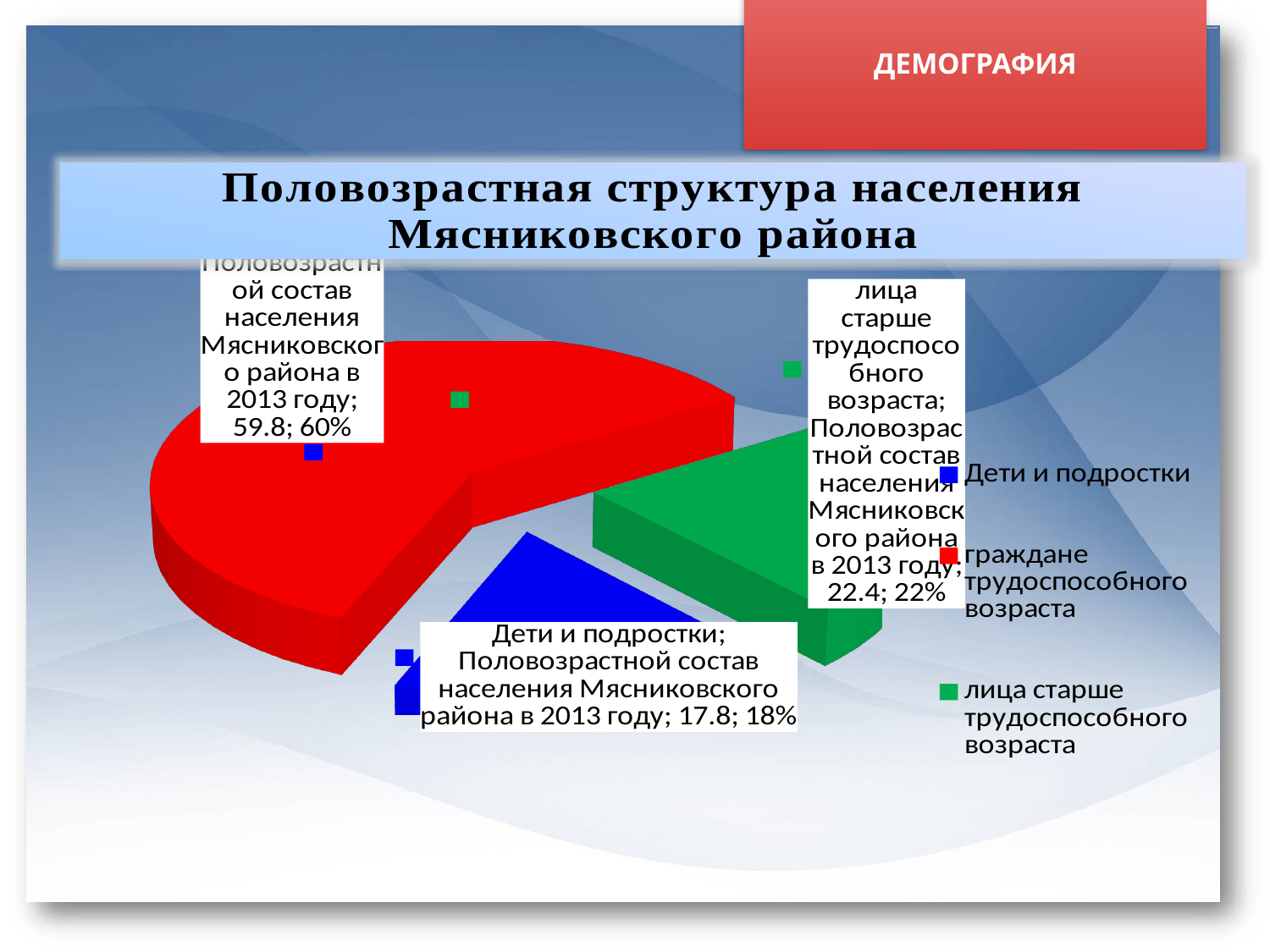
What value is printed on the data label of the red slice (граждане трудоспособного возраста)? 59.8 How many slices does the pie chart have? 3 Which category has the smallest slice in the pie chart? Дети и подростки What kind of chart is shown on the slide? pie chart Which category has the largest slice in the pie chart? граждане трудоспособного возраста What percentage share does the slice for "Дети и подростки" have in the pie chart? 18% Which colour represents "Дети и подростки" in the pie chart? blue What percentage share does the slice for "лица старше трудоспособного возраста" have? 22% What is the difference between the values for "лица старше трудоспособного возраста" and "Дети и подростки"? 4.6 What value is printed on the data label for "лица старше трудоспособного возраста"? 22.4 How many entries does the legend of the pie chart list? 3 What value is printed on the data label for "Дети и подростки"? 17.8